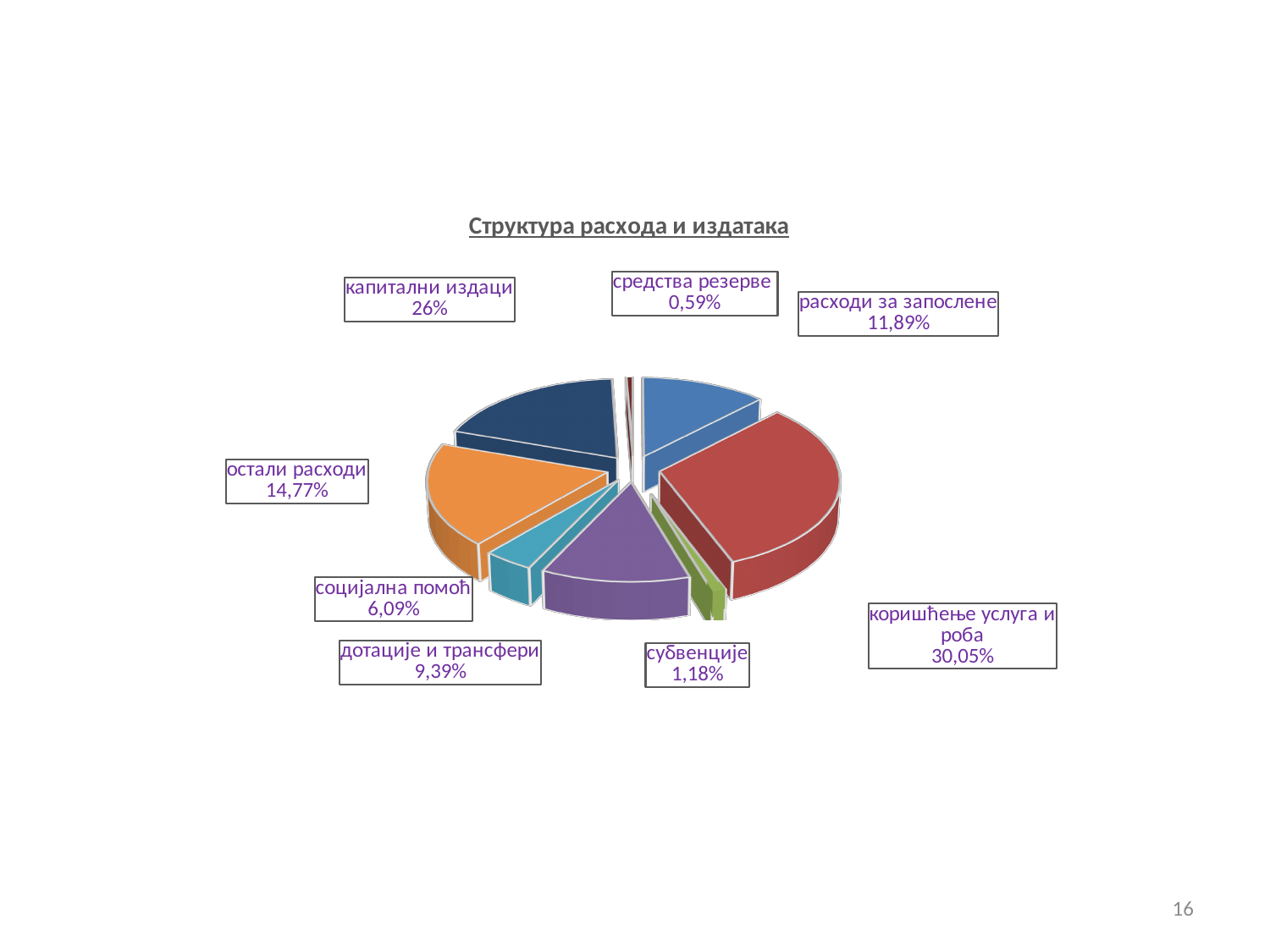
What kind of chart is shown on the slide? pie chart What is the value shown for средства резерве? 0,59% Which category has the smallest share of the pie? средства резерве What is the value shown for капитални издаци? 26% How many slices does the pie chart have? 8 What is the value shown for расходи за запослене? 11,89% What is the difference between the shares of остали расходи and социјална помоћ? 8,68% What is the value shown for социјална помоћ? 6,09% Which category has the largest share of the pie? коришћење услуга и роба What share of the pie is коришћење услуга и роба? 30,05% Which is larger, дотације и трансфери or субвенције? дотације и трансфери What is the title of the chart? Структура расхода и издатака